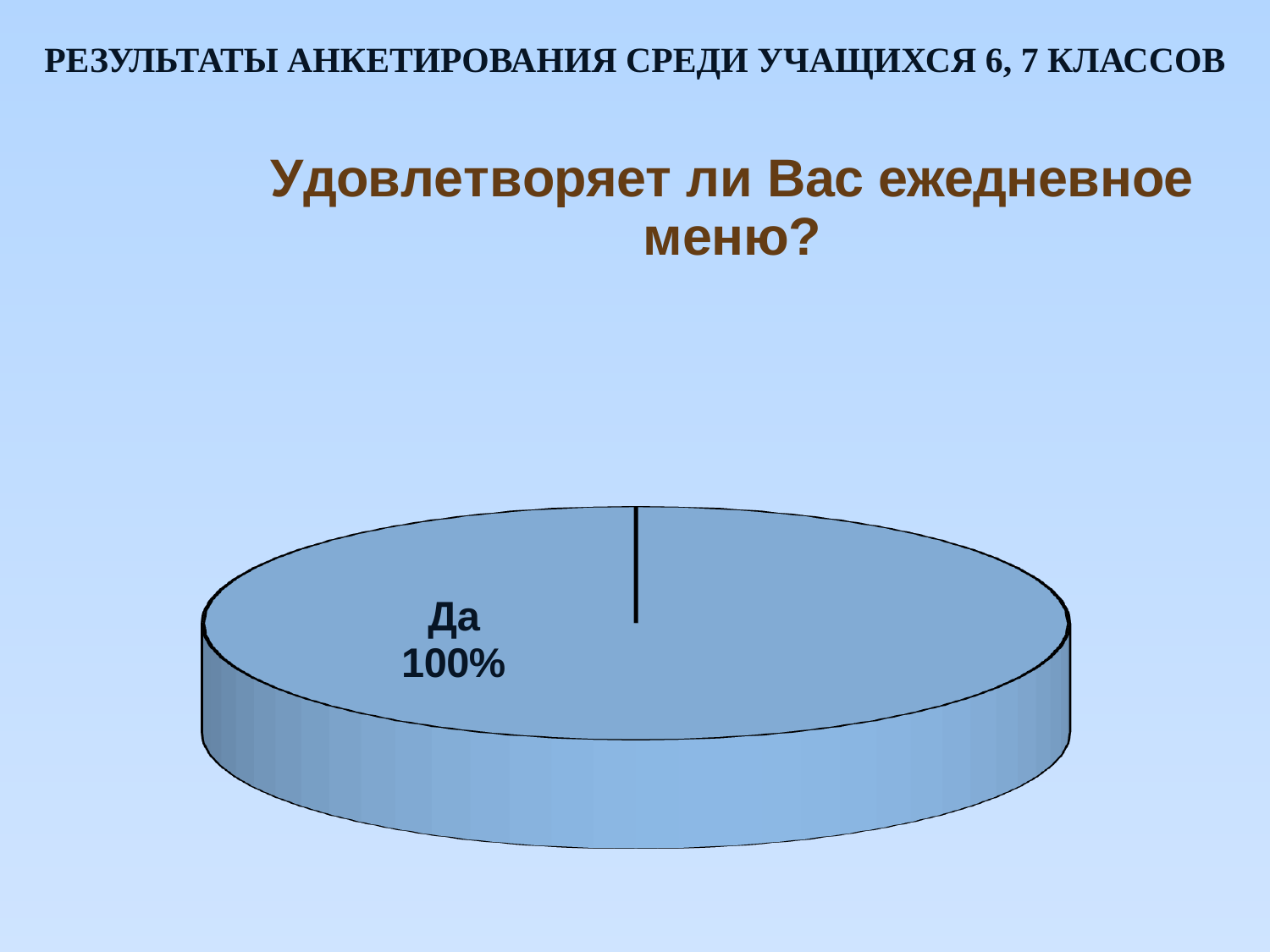
What kind of chart is shown on the slide? pie chart What is the label of the only slice in the pie chart? Да How many slices does the pie chart have? 1 Which category is the largest slice of the pie chart? Да Is the value for "Да" greater or less than 50%? greater What is the title of the chart? Удовлетворяет ли Вас ежедневное меню? What share of the pie does the slice "Да" take? 100% What value is printed on the slice labelled "Да"? 100%